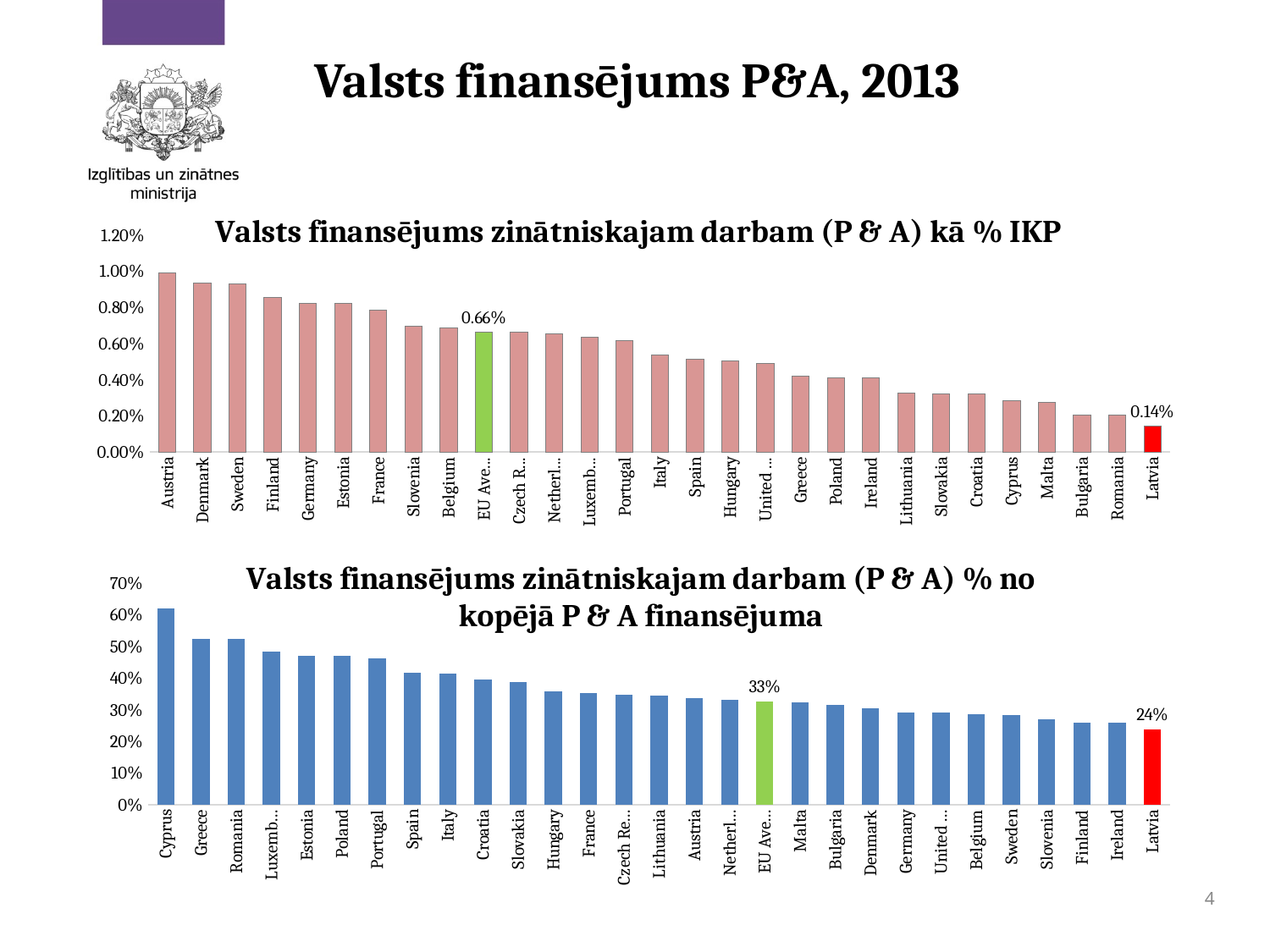
In the top chart (P & A kā % IKP), which is larger, Denmark or Greece? Denmark In the bottom chart (% no kopējā P & A finansējuma), how much lower is Latvia than the EU average? 9% In the bottom chart (% no kopējā P & A finansējuma), which country has the highest value? Cyprus In the bottom chart (% no kopējā P & A finansējuma), which country has the lowest value? Latvia In the top chart (P & A kā % IKP), what is the value for the EU average bar? 0.66% In the top chart (P & A kā % IKP), is the value for Austria greater or less than 0.80%? greater What kind of chart is the bottom chart on the slide? Bar chart In the top chart (P & A kā % IKP), what is the value for Latvia? 0.14% In the bottom chart (% no kopējā P & A finansējuma), what is the value for Latvia? 24% In the bottom chart (% no kopējā P & A finansējuma), what is the value for the EU average bar? 33% In the top chart (P & A kā % IKP), what is the difference between the EU average and Latvia? 0.52% In the top chart (P & A kā % IKP), which country has the highest value? Austria